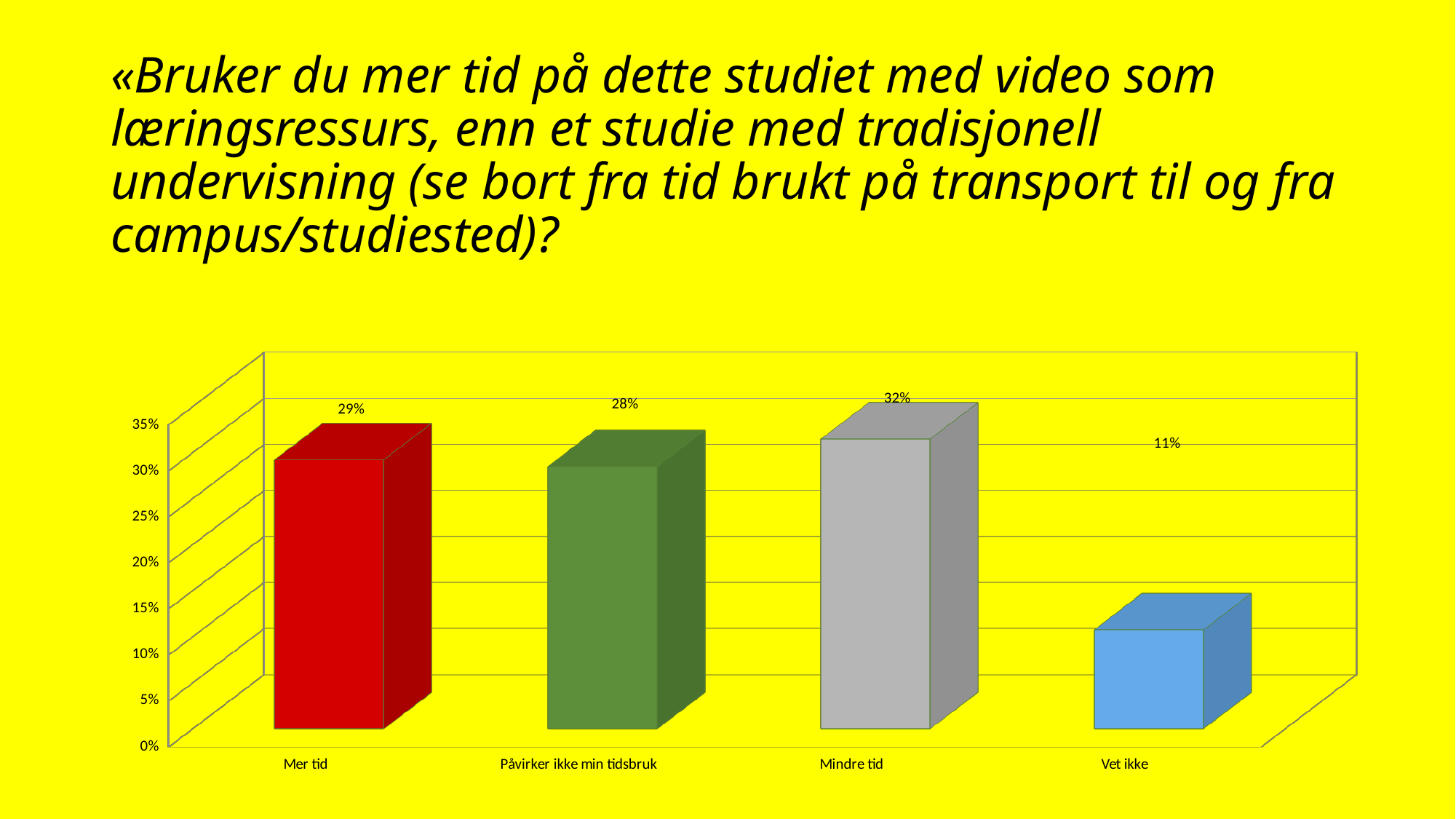
Which category has the lowest value? Vet ikke What is the value for "Mindre tid"? 32% Is the value for "Vet ikke" greater or less than 15%? less Which category has the highest value? Mindre tid How many categories are shown on the x axis? 4 What is the value for "Påvirker ikke min tidsbruk"? 28% What is the value for "Vet ikke"? 11% What is the difference between the values for "Mer tid" and "Påvirker ikke min tidsbruk"? 1% Which is larger, the value for "Mindre tid" or the value for "Vet ikke"? Mindre tid What is the difference between the values for "Mindre tid" and "Vet ikke"? 21% What is the value for "Mer tid"? 29% What kind of chart is shown on the slide? Bar chart